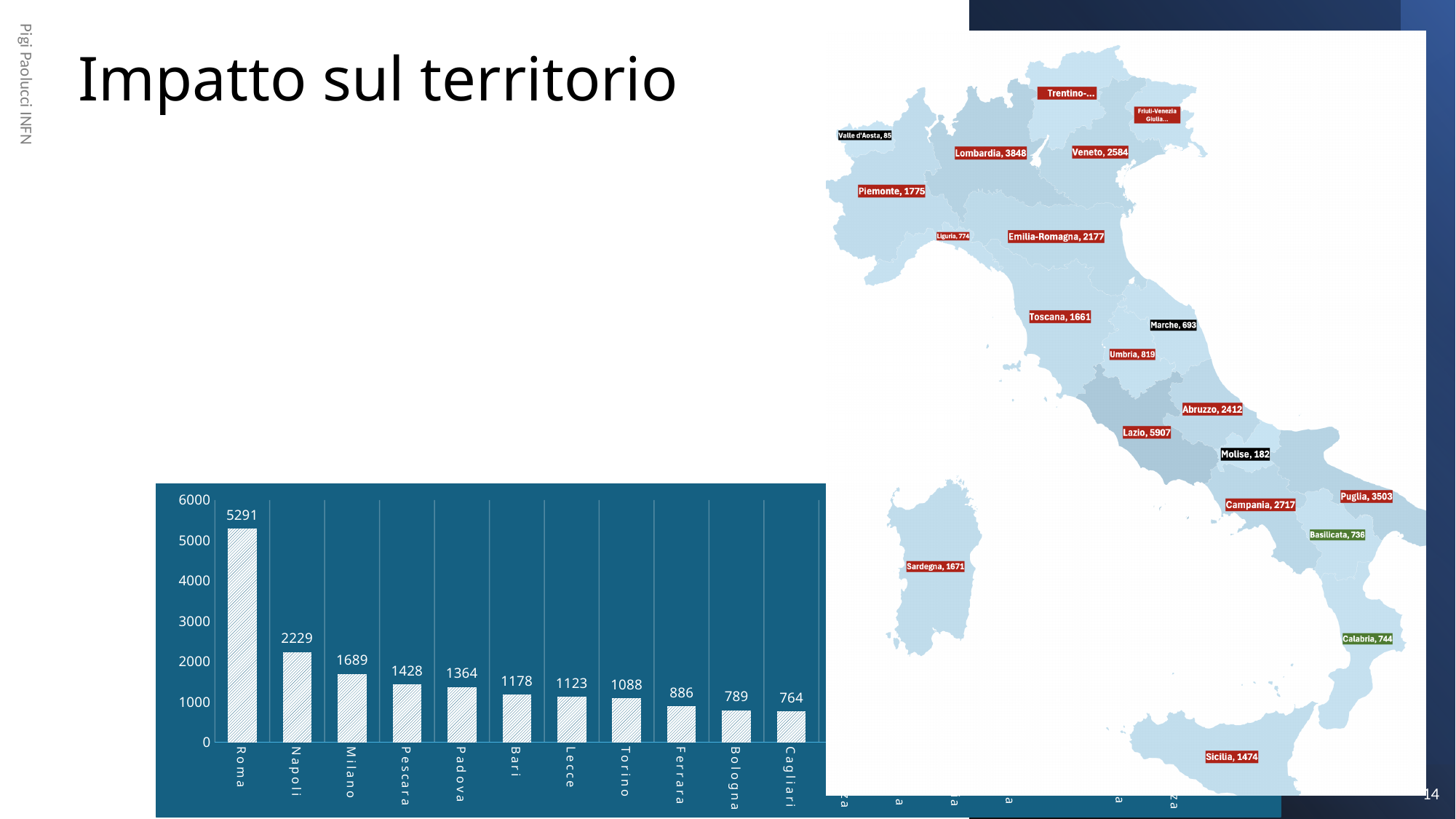
In the bar chart at the bottom left, which has a larger value, Milano or Pescara? Milano In the map chart on the right, which has a larger value, Puglia or Campania? Puglia In the bar chart at the bottom left, what is the difference between the values for Roma and Napoli? 3062 In the bar chart at the bottom left, what is the value for Napoli? 2229 In the map chart on the right, which region has the highest value? Lazio In the map chart on the right, what is the value for Sicilia? 1474 In the map chart on the right, what is the value for Lombardia? 3848 In the bar chart at the bottom left, what is the value for Torino? 1088 In the bar chart at the bottom left, is the value for Bologna greater or less than 1000? less What type of chart is shown at the bottom left of the slide? bar chart In the bar chart at the bottom left, which city has the highest value? Roma In the bar chart at the bottom left, what is the value for Roma? 5291